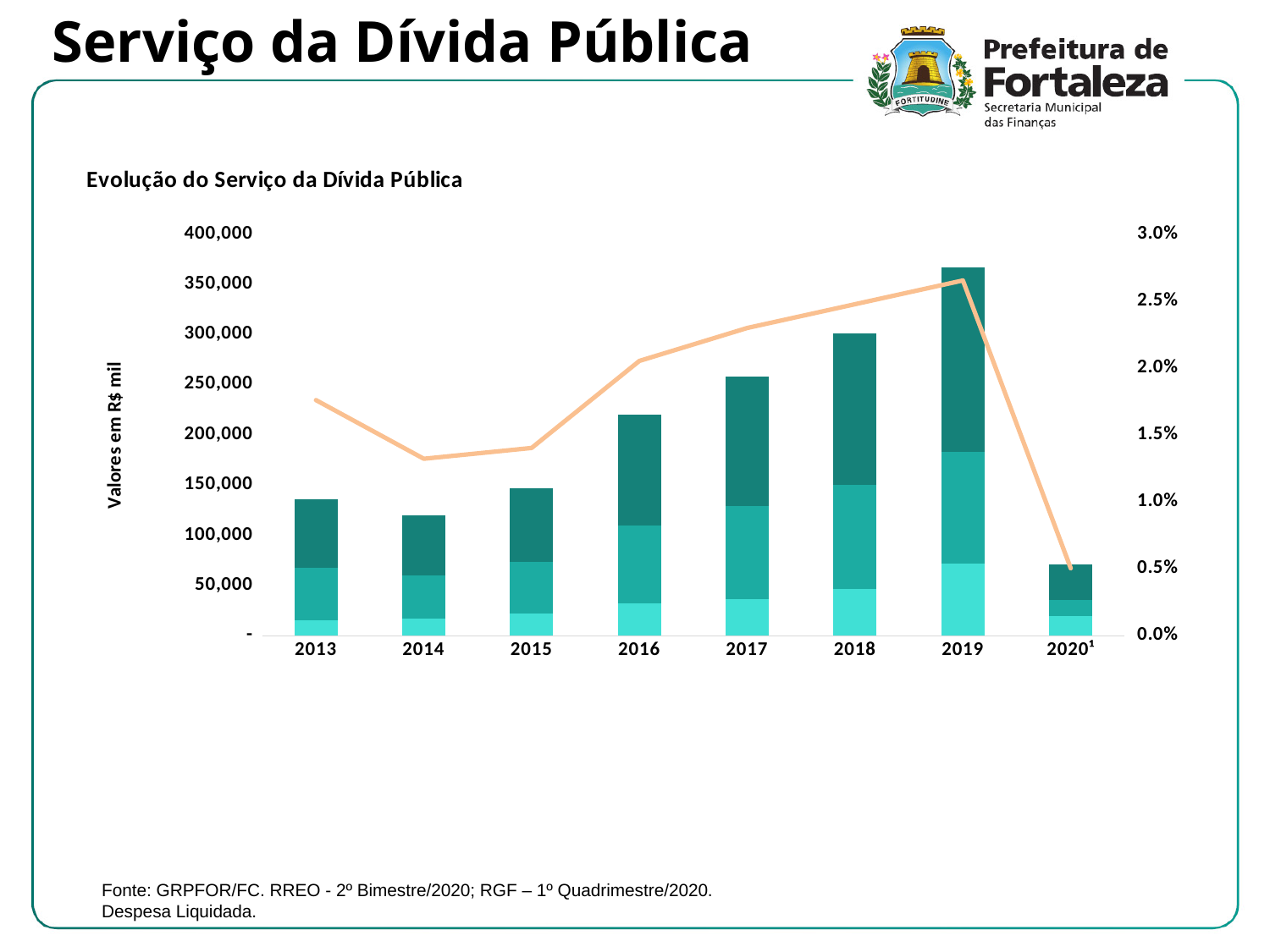
Which year has the tallest stacked bar? 2019 What is the title of the chart? Evolução do Serviço da Dívida Pública Is the line value for 2020¹ greater or less than 1.0%? less Which year has the taller stacked bar, 2015 or 2017? 2017 Is the total bar value for 2020¹ greater or less than 100,000? less Which year has the shortest stacked bar? 2020¹ How many years are shown on the x axis of the chart? 8 Do the stacked bars rise or fall from 2016 to 2019? rise Is the total bar value for 2016 greater or less than 200,000? greater What kind of chart is shown on the slide? Stacked bar chart with a line